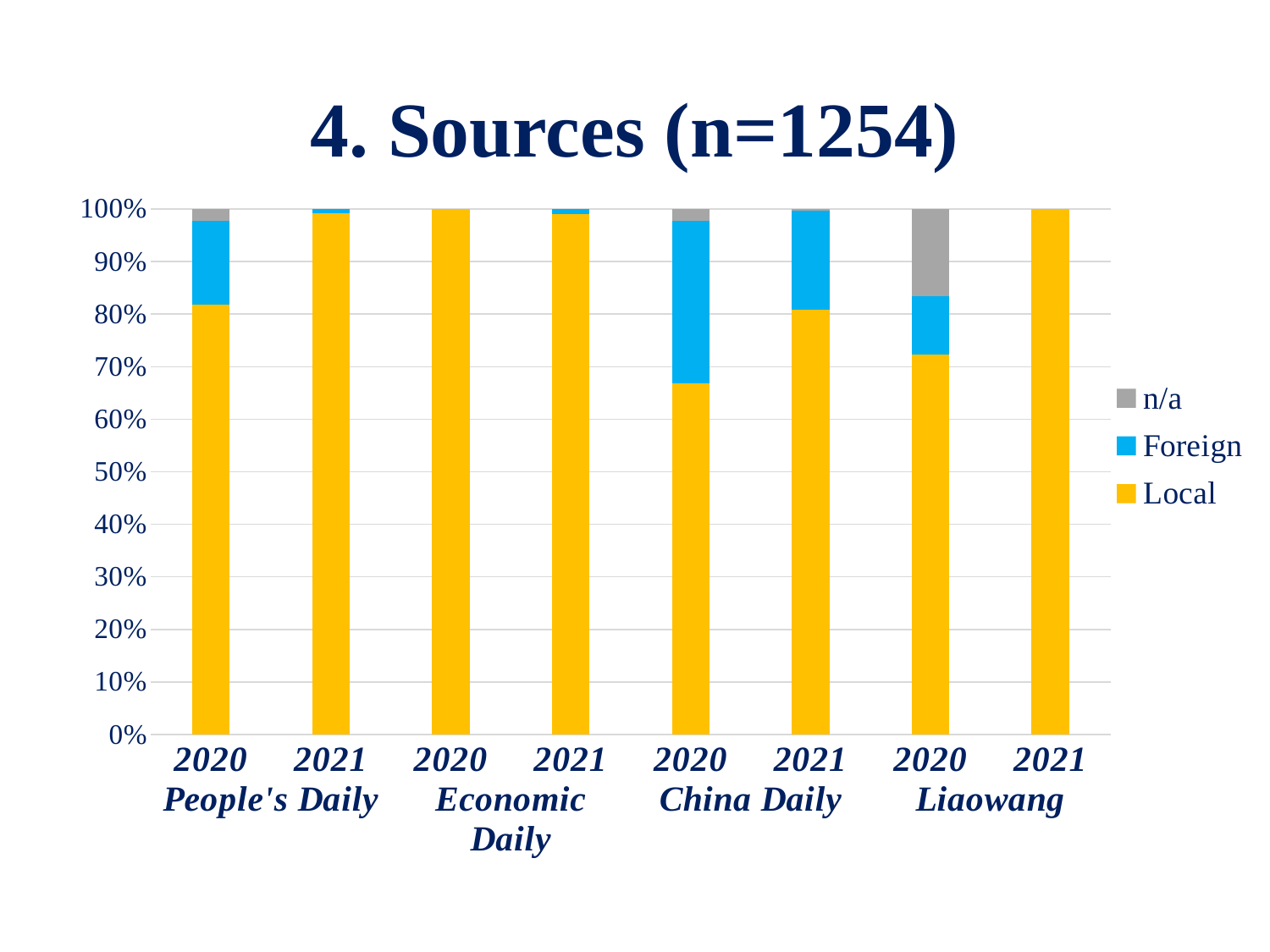
Which bar has the lowest Local share? China Daily 2020 Which colour represents the Local series in the legend? Yellow How many bars are plotted in the chart? 8 Which has a larger Local share: People's Daily 2020 or China Daily 2020? People's Daily 2020 What does each stacked bar total on the y axis? 100% How many series does the legend list? 3 Is the Local share for China Daily in 2020 greater or less than 70%? less Is the Local share for People's Daily in 2020 greater or less than 80%? greater What kind of chart is shown on the slide? Stacked bar chart What is the title of the chart? 4. Sources (n=1254) Is the n/a share for Liaowang in 2020 greater or less than 10%? greater